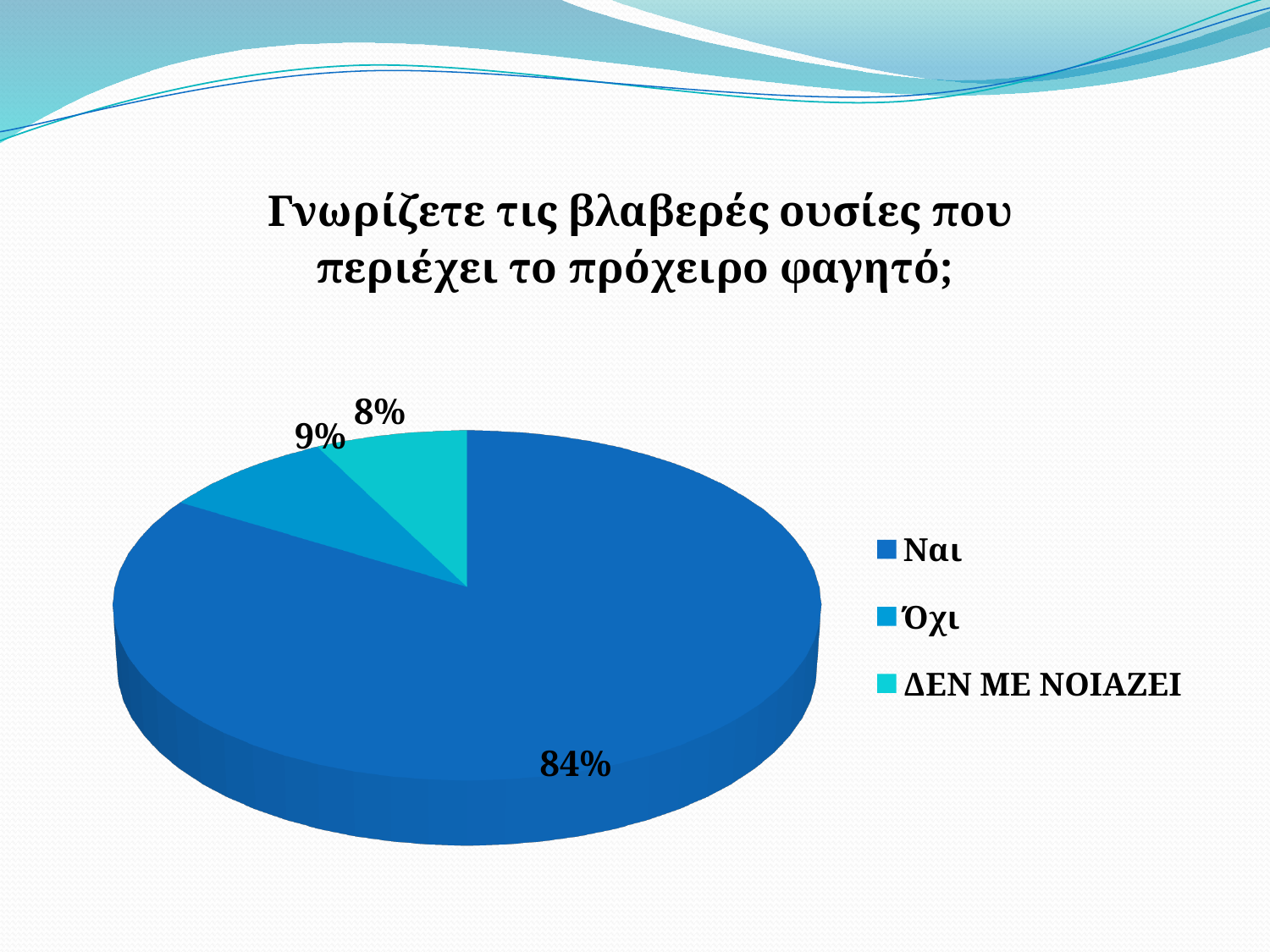
Which is larger, the share for Ναι or the share for Όχι? Ναι What percentage of respondents answered ΔΕΝ ΜΕ ΝΟΙΑΖΕΙ? 8% What is the title of the chart? Γνωρίζετε τις βλαβερές ουσίες που περιέχει το πρόχειρο φαγητό; What is the difference in percentage points between Ναι and Όχι? 75 What percentage of respondents answered Ναι? 84% What type of chart is shown on the slide? pie chart What is the difference in percentage points between Όχι and ΔΕΝ ΜΕ ΝΟΙΑΖΕΙ? 1 What percentage of respondents answered Όχι? 9% Which category has the largest share of the pie? Ναι How many categories does the pie chart show? 3 Which category has the smallest share of the pie? ΔΕΝ ΜΕ ΝΟΙΑΖΕΙ How many entries does the legend list? 3